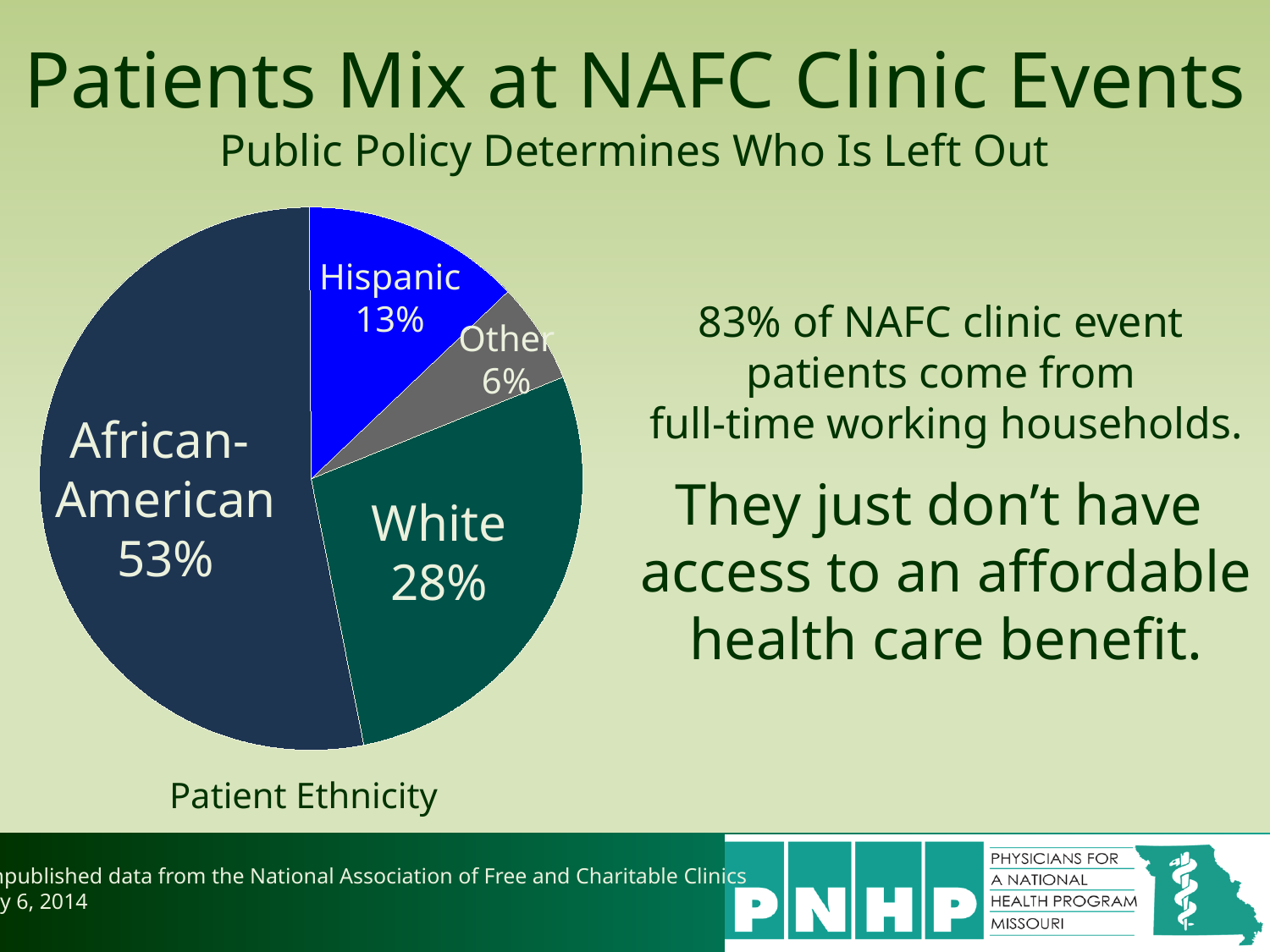
What percentage of patients are Hispanic? 13% Which is larger, the Hispanic share or the Other share? Hispanic What percentage of patients fall in the Other category? 6% What type of chart is shown on the slide? pie chart What is the label shown beneath the pie chart? Patient Ethnicity What percentage of patients are African-American? 53% Which ethnicity has the smallest share of patients? Other What is the difference in percentage points between the African-American and White shares? 25 What colour is the Hispanic slice? blue What percentage of patients are White? 28% Which ethnicity has the largest share of patients? African-American How many slices does the pie chart have? 4